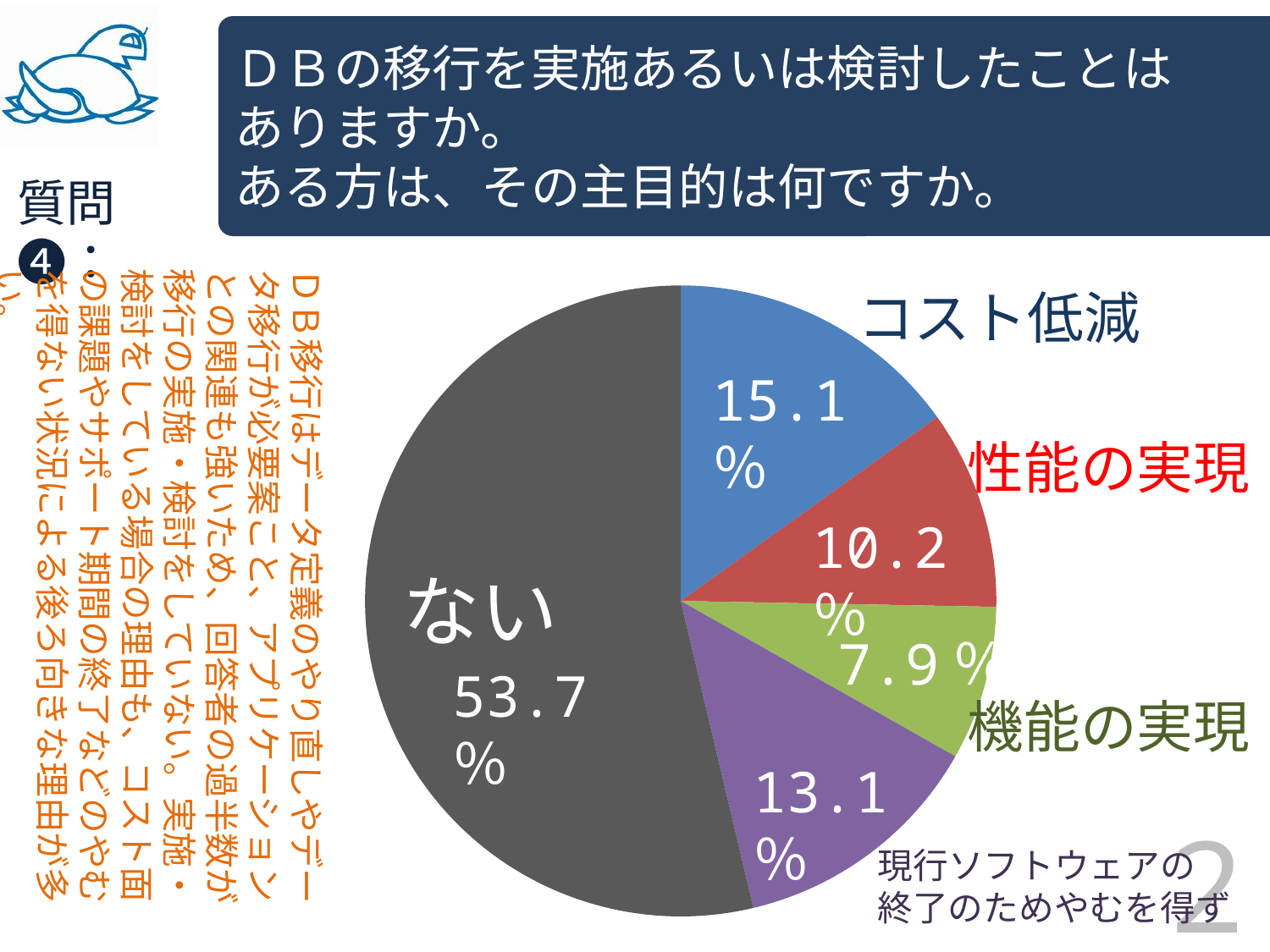
What is the difference in percentage points between コスト低減 and 機能の実現? 7.2 What percentage is shown for 性能の実現? 10.2% Which is larger, コスト低減 or 性能の実現? コスト低減 Which slice of the pie chart is the largest? ない How many slices does the pie chart have? 5 What percentage is shown for 現行ソフトウェアの終了のためやむを得ず? 13.1% What percentage is shown for コスト低減? 15.1% Which slice of the pie chart is the smallest? 機能の実現 What percentage is shown for the ない slice? 53.7% What percentage is shown for 機能の実現? 7.9% What kind of chart is shown on the slide? pie chart What colour is the ない slice of the pie chart? dark grey